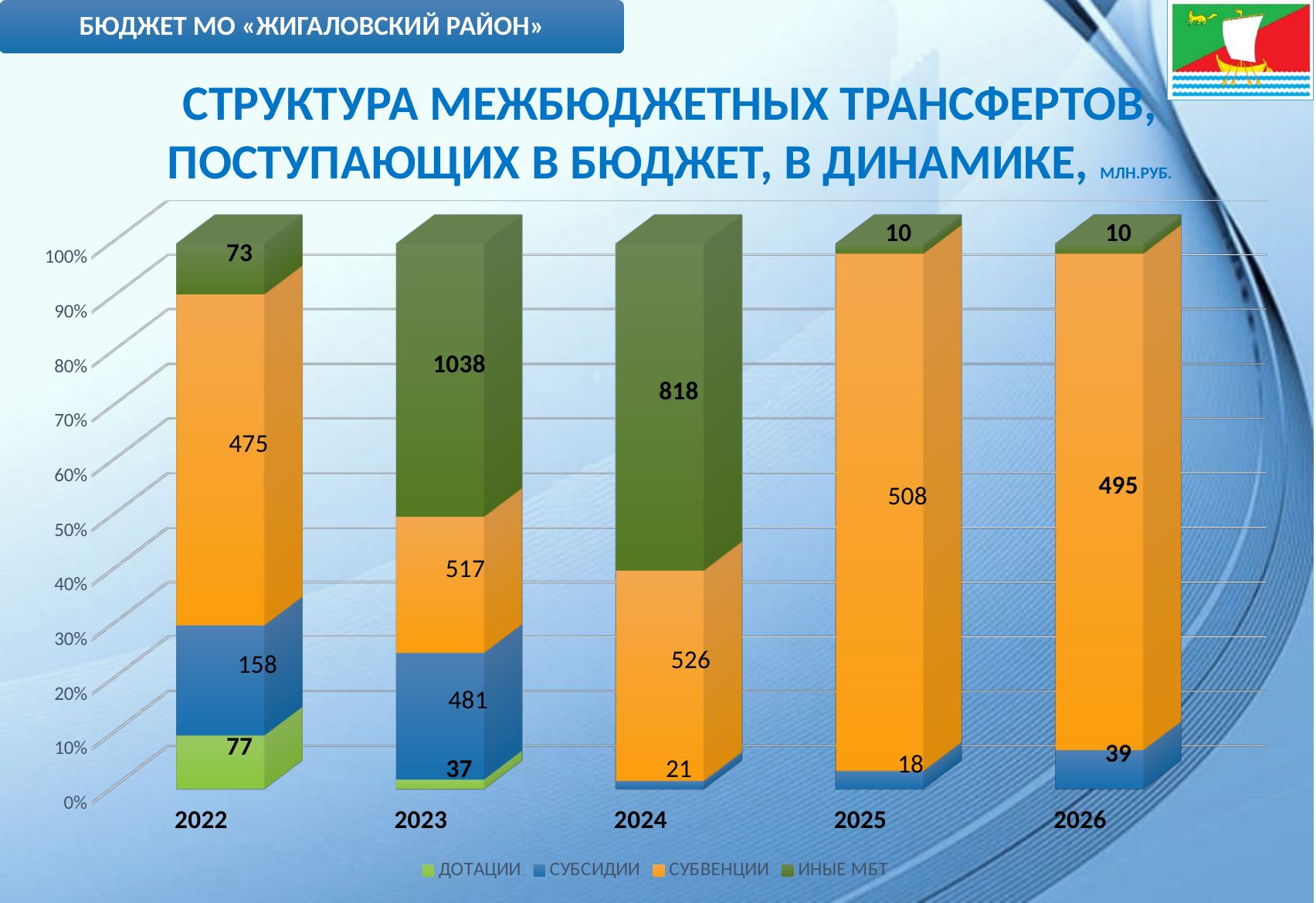
What is the total of all labelled segments in the 2022 bar? 783 In which year is the labelled value for ИНЫЕ МБТ the highest? 2023 What is the difference between the СУБВЕНЦИИ values for 2025 and 2026? 13 What is the value of ИНЫЕ МБТ for 2023? 1038 What is the value of СУБСИДИИ for 2025? 18 What is the value of СУБВЕНЦИИ for 2022? 475 Is the share of ИНЫЕ МБТ in the 2024 bar greater or less than 50%? greater What kind of chart is shown on the slide? Stacked bar chart How many years are shown along the x axis of the chart? 5 How many series does the legend list? 4 What is the value of ДОТАЦИИ for 2022? 77 Which year has the larger СУБСИДИИ value, 2022 or 2023? 2023